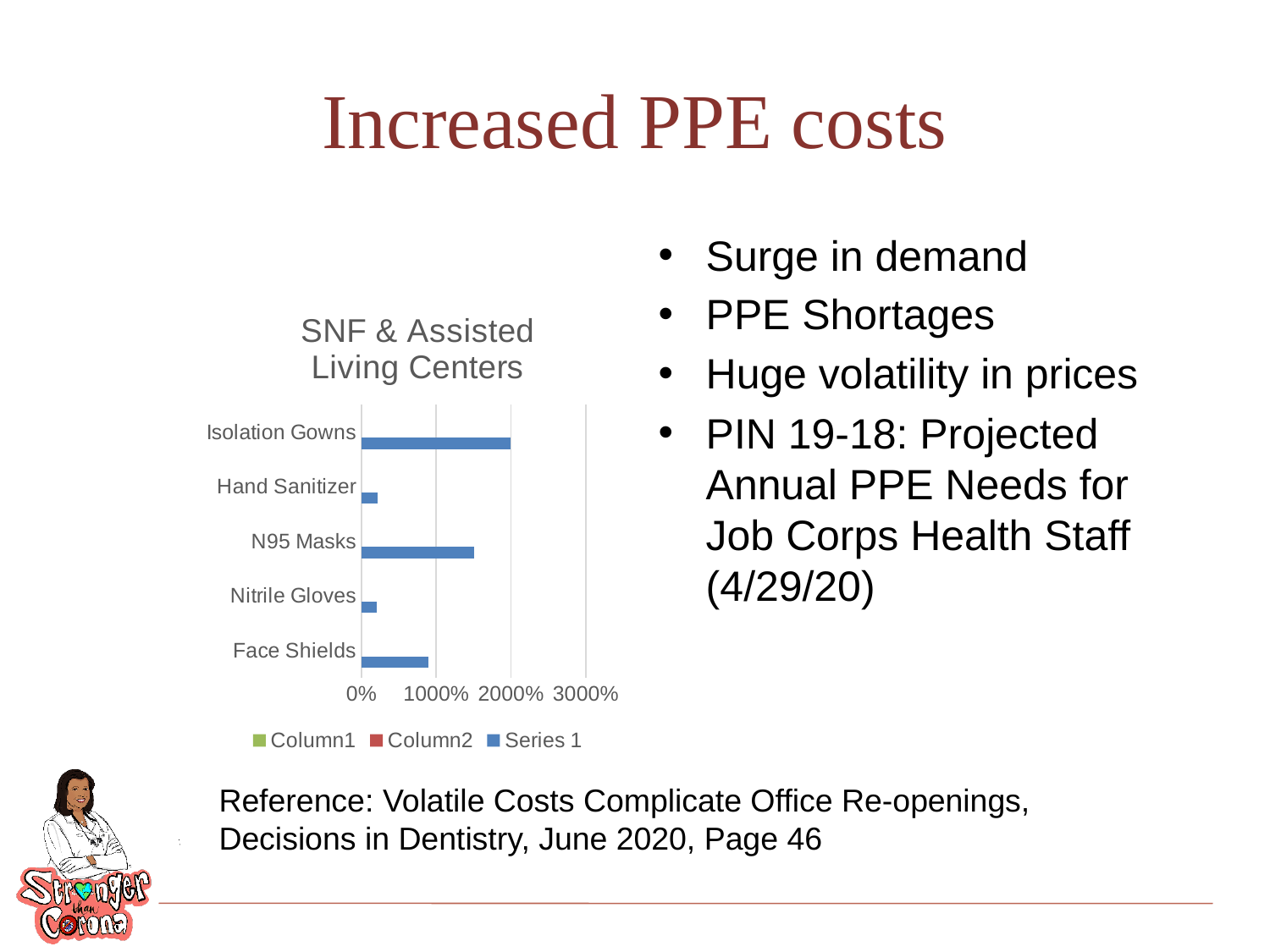
Is the value for Hand Sanitizer greater or less than 1000%? less Is the value for Face Shields greater or less than 1000%? less Which is larger, the value for Isolation Gowns or the value for N95 Masks? Isolation Gowns Is the value for N95 Masks greater or less than 2000%? less What kind of chart is shown on the slide? bar chart How many series does the chart legend list? 3 How many categories are shown on the chart? 5 What is the title of the chart? SNF & Assisted Living Centers Which category has the highest value on the chart? Isolation Gowns Which is larger, the value for N95 Masks or the value for Face Shields? N95 Masks